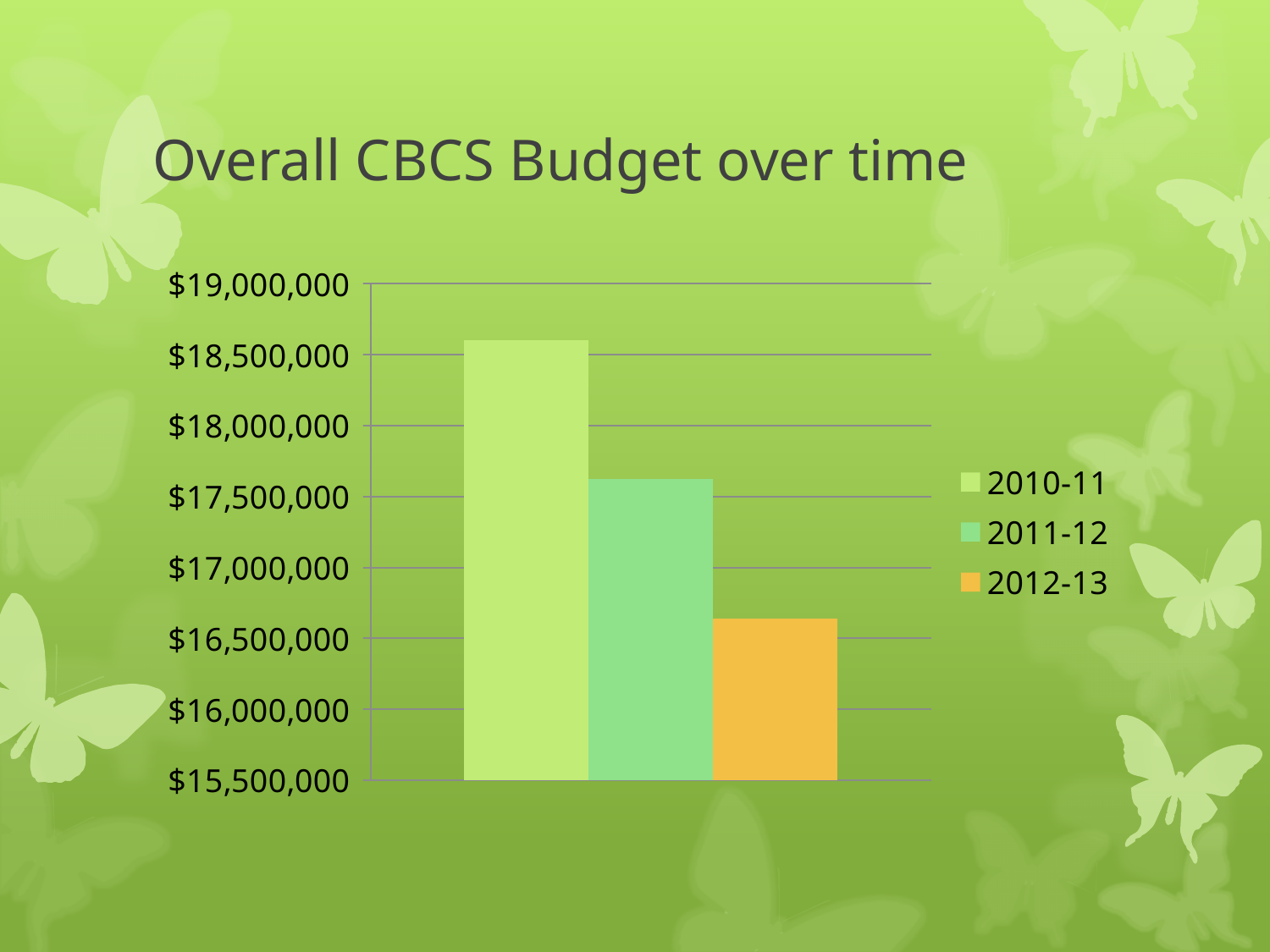
Do the budget values rise or fall from 2010-11 to 2012-13? Fall How many entries does the legend list? 3 What colour is the bar for 2012-13? Orange Is the value for 2012-13 greater or less than $17,000,000? less Which year has the highest budget? 2010-11 Which is larger, the budget for 2011-12 or the budget for 2012-13? 2011-12 Is the value for 2010-11 greater or less than $18,000,000? greater Which year has the lowest budget? 2012-13 Is the value for 2011-12 greater or less than $18,000,000? less How many bars are plotted in the chart? 3 What kind of chart is shown on the slide? Bar chart What is the title of the slide? Overall CBCS Budget over time